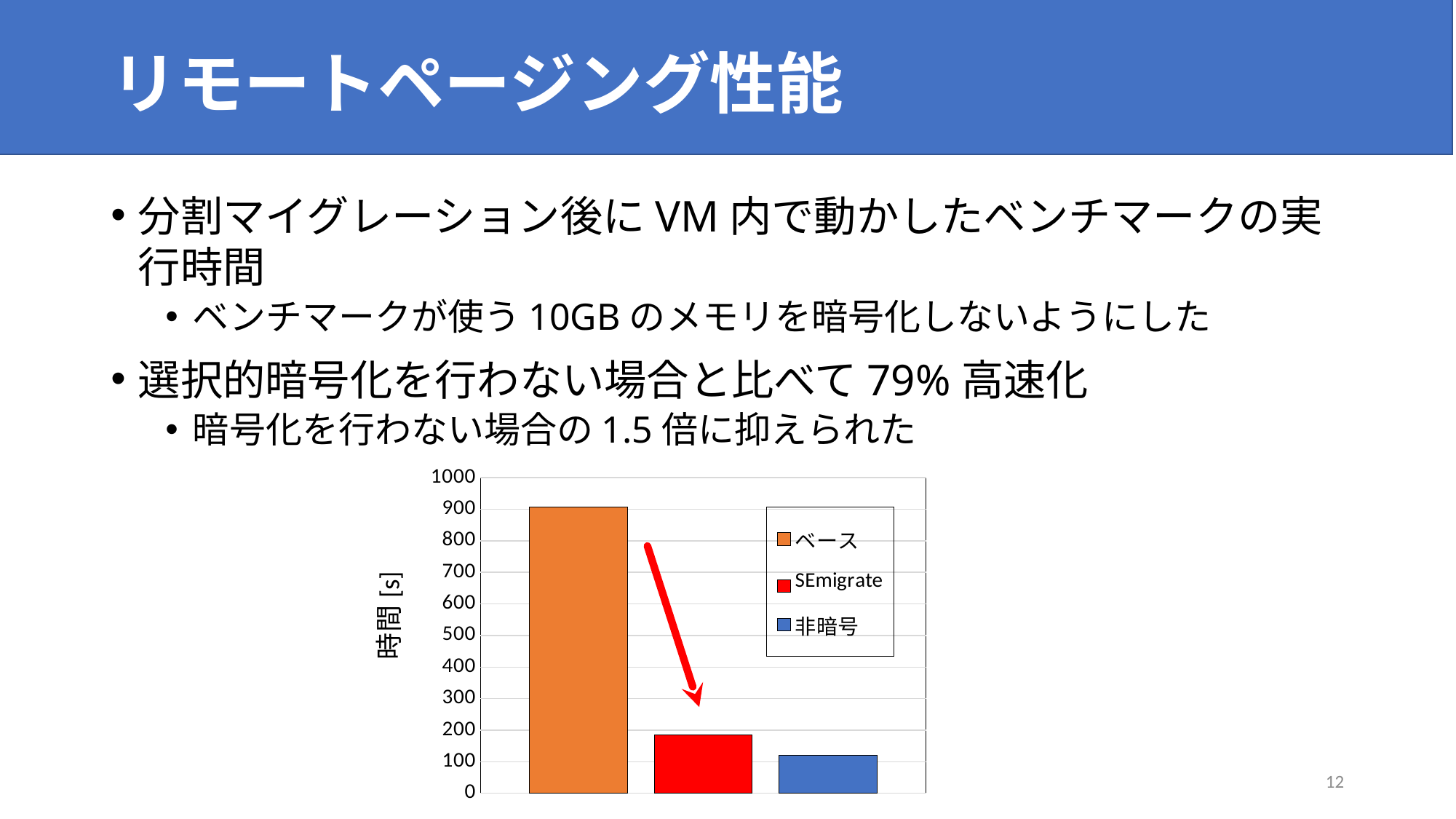
Is the value for ベース greater or less than 1000? less How many series does the chart legend list? 3 What is the label of the vertical axis of the chart? 時間 [s] Is the value for 非暗号 greater or less than 200? less Which is larger, the value for SEmigrate or the value for 非暗号? SEmigrate Is the value for ベース greater or less than 800? greater What colour is the bar for SEmigrate in the chart? red Which series has the lowest value in the chart? 非暗号 How many bars are plotted in the chart? 3 Which series has the highest value in the chart? ベース What kind of chart is shown on the slide? bar chart